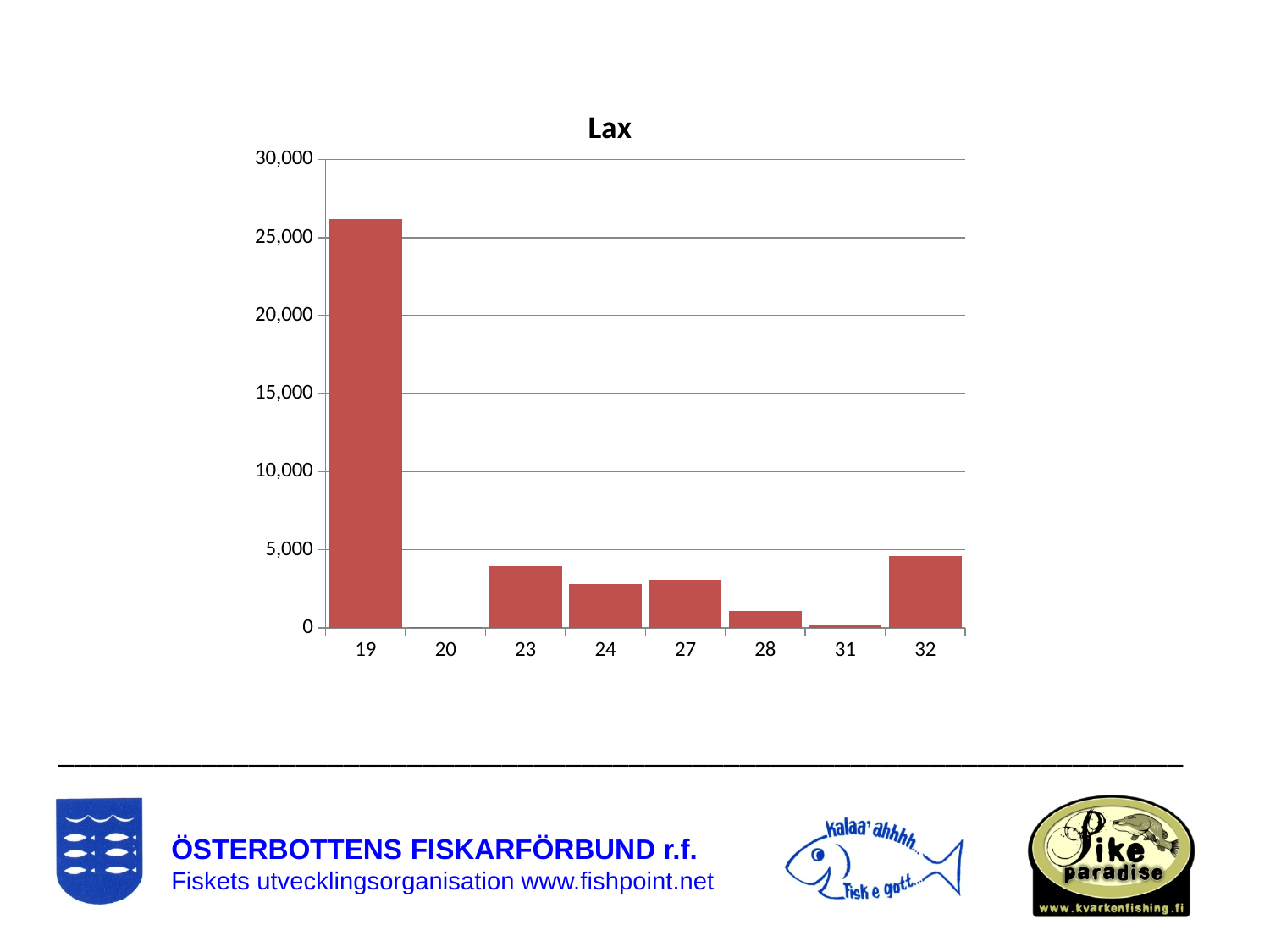
What kind of chart is shown on the slide? bar chart Is the value for category 23 greater or less than 5,000? less Which category has the highest value in the chart? 19 Which has the larger value, category 19 or category 32? 19 Is the value for category 19 greater or less than 25,000? greater Which has the larger value, category 32 or category 24? 32 Which category has the lowest value in the chart? 20 Is the value for category 28 greater or less than 5,000? less How many categories are shown on the x axis of the chart? 8 Which has the larger value, category 23 or category 28? 23 What is the title of the chart? Lax